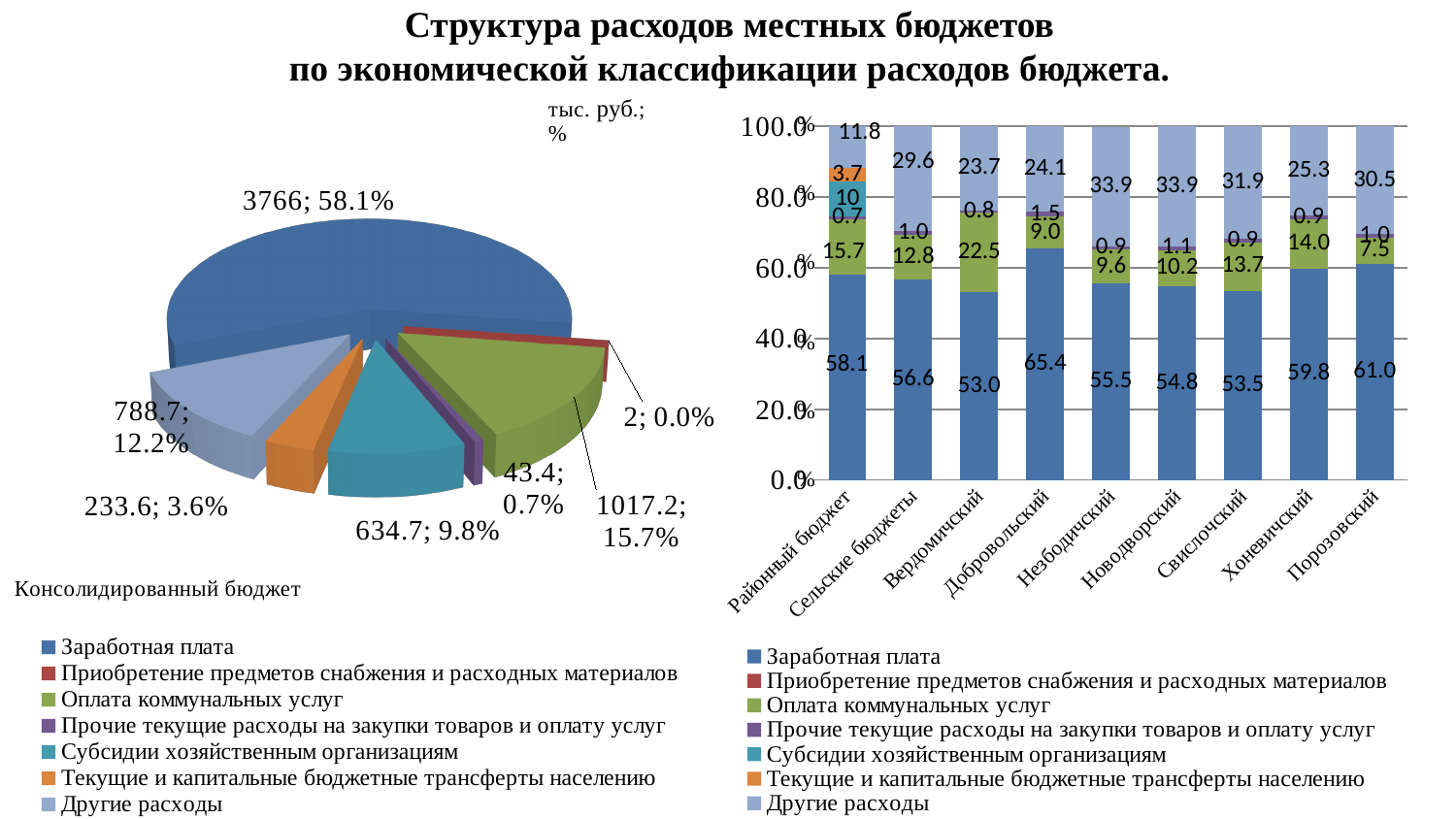
What type of chart is shown on the right side of the slide? Stacked bar chart In the left pie chart, what share does Оплата коммунальных услуг have? 15.7% In the left pie chart, how many slices are there? 7 In the left pie chart, which category has the smallest slice? Приобретение предметов снабжения и расходных материалов In the right stacked bar chart, what is the difference between the Заработная плата values for Порозовский and Вердомичский? 8.0 In the right stacked bar chart, how many categories are shown on the x axis? 9 In the right stacked bar chart, which is larger: Другие расходы for Сельские бюджеты or for Хоневичский? Сельские бюджеты In the right stacked bar chart, which category has the lowest value for Заработная плата? Вердомичский In the left pie chart (Консолидированный бюджет), what value and share are shown for Заработная плата? 3766; 58.1% In the right stacked bar chart, which category has the highest value for Заработная плата? Добровольский In the right stacked bar chart, what is the value of Заработная плата for Добровольский? 65.4 In the left pie chart, what value is shown for Другие расходы? 788.7